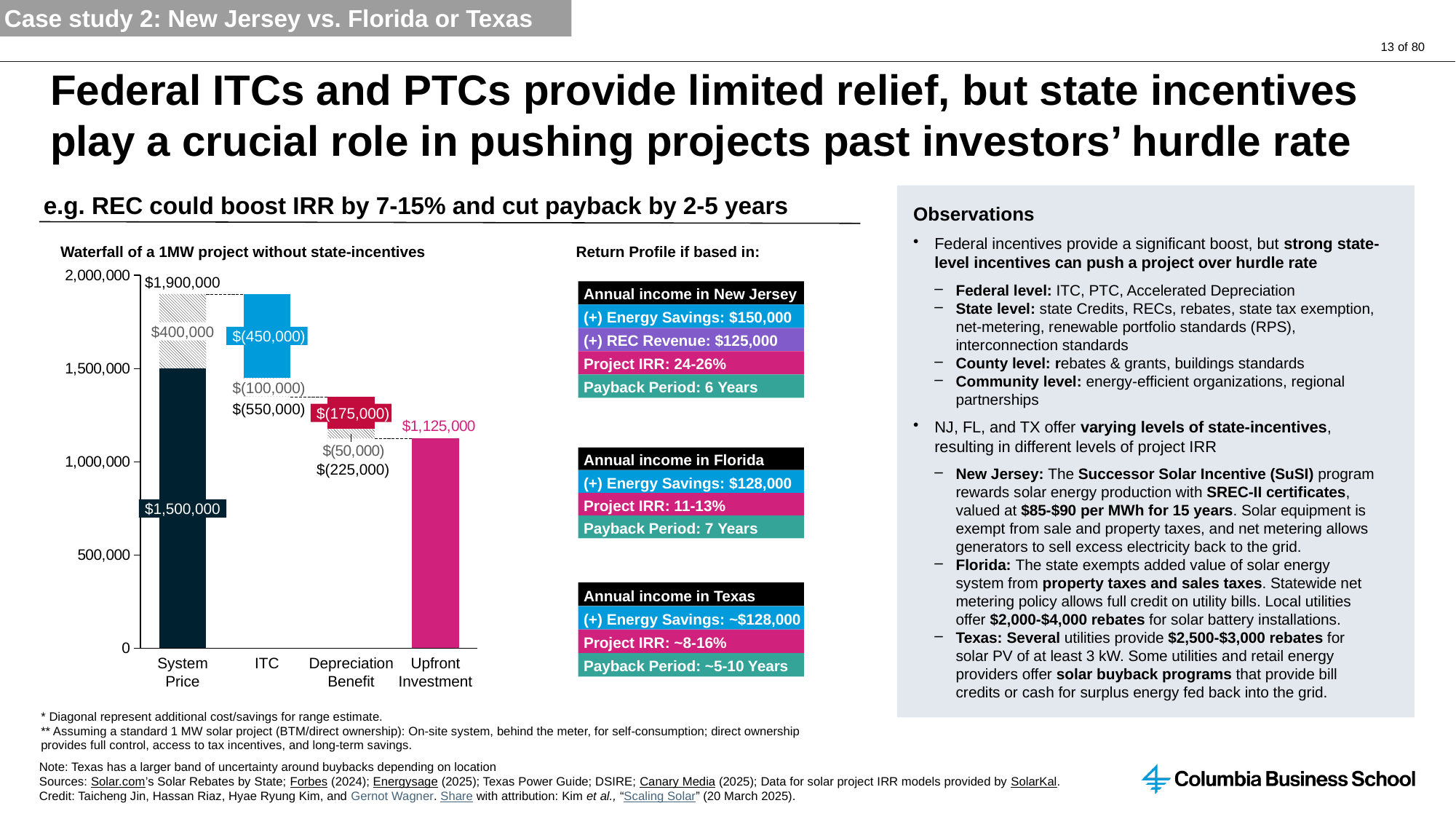
How many categories are shown on the x axis of the waterfall chart? 4 In the waterfall chart, which category has the largest bar? System Price What kind of chart is the 'Waterfall of a 1MW project without state-incentives'? Bar chart (waterfall) In the waterfall chart, what is the value labelled on the Upfront Investment bar? $1,125,000 In the waterfall chart, is the Upfront Investment bar greater or less than 1,000,000? greater In the waterfall chart, what is the upper range value shown above the System Price bar? $1,900,000 In the waterfall chart, what is the difference between the System Price value ($1,500,000) and the Upfront Investment value ($1,125,000)? $375,000 In the waterfall chart, what is the additional cost range shown on the System Price bar? $400,000 In the waterfall chart, what is the value labelled on the Depreciation Benefit bar? $(175,000) What is the title of the chart on the left of the slide? Waterfall of a 1MW project without state-incentives In the waterfall chart, what is the value labelled on the System Price bar? $1,500,000 In the waterfall chart, what is the value labelled on the ITC bar? $(450,000)